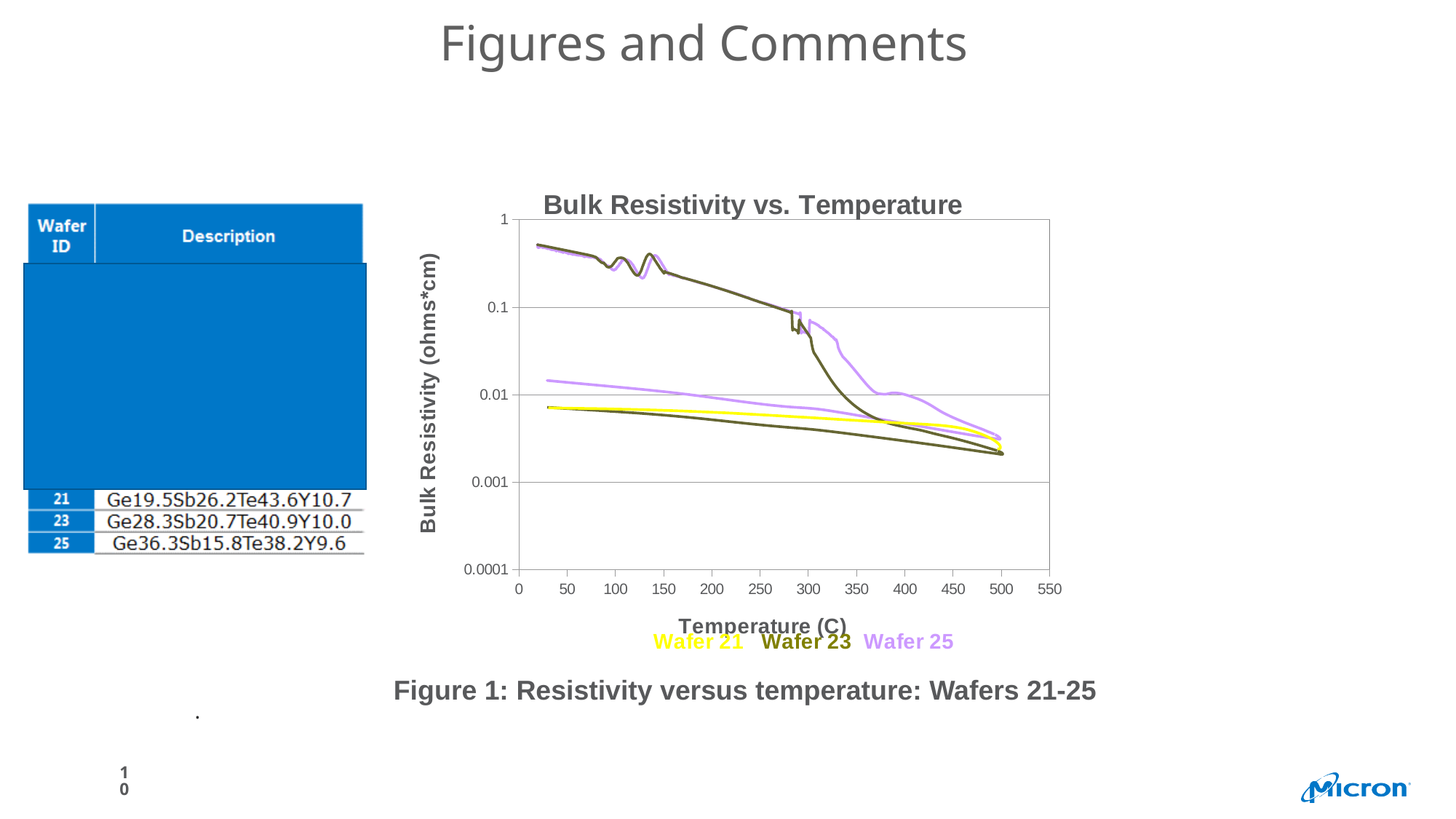
Does the resistivity of Wafer 21 rise or fall as temperature increases? fall What is the largest temperature tick shown on the x axis? 550 What is the label of the y axis of the chart? Bulk Resistivity (ohms*cm) How many series does the legend of the chart list? 3 Is the highest value reached by Wafer 23 greater or less than 0.1? greater Is the value for Wafer 21 at 500 C greater or less than 0.001? greater What kind of chart is shown on the slide? line chart What is the title of the chart? Bulk Resistivity vs. Temperature